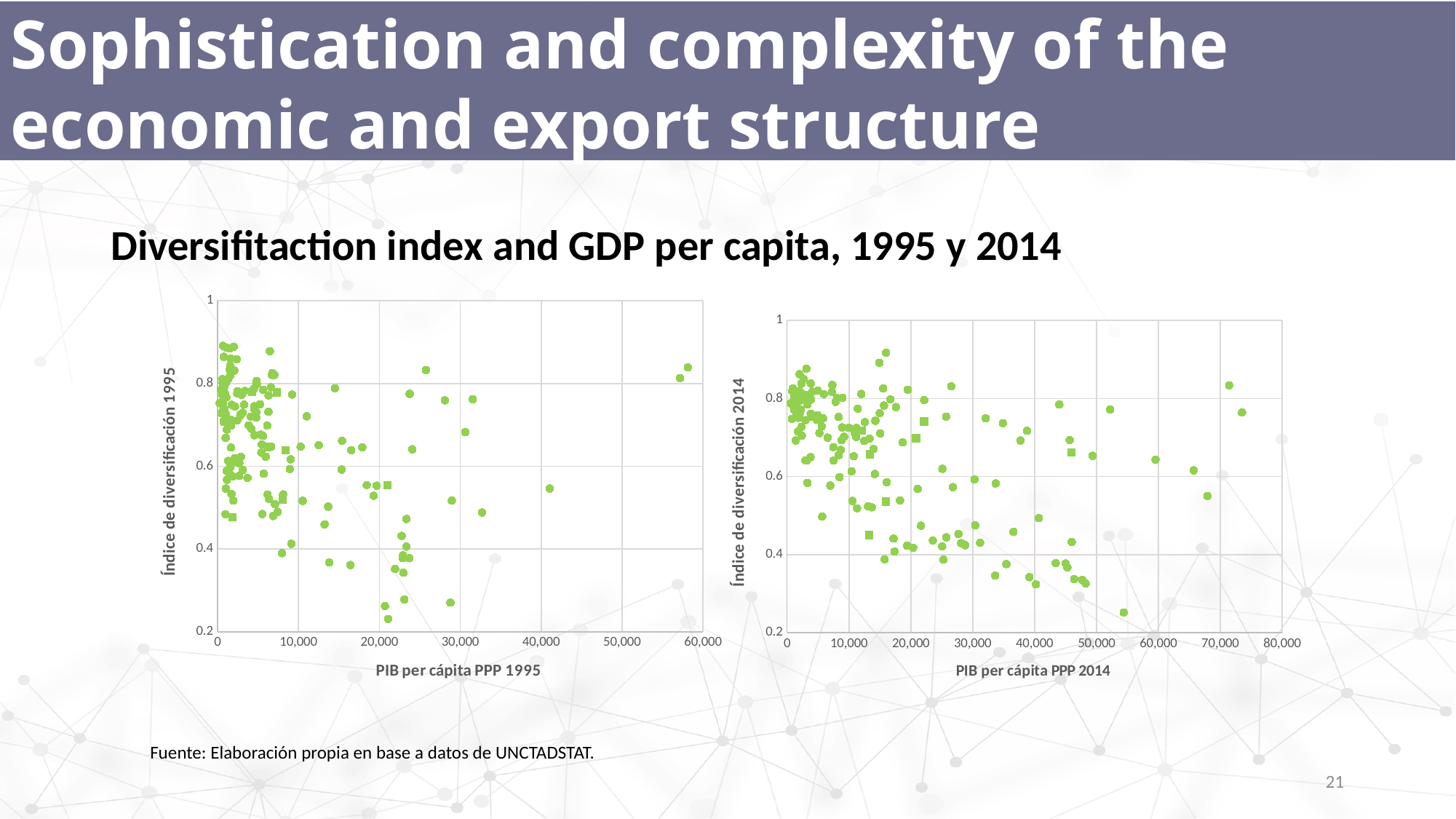
In the left chart (1995), do the diversification index values generally rise or fall as GDP per capita increases along the x axis? fall What is the x-axis title of the left chart? PIB per cápita PPP 1995 What kind of chart is the left chart (PIB per cápita PPP 1995)? scatter chart What kind of chart is the right chart (PIB per cápita PPP 2014)? scatter chart How many charts are shown on the slide? 2 In the right chart (2014), do the diversification index values generally rise or fall as GDP per capita increases along the x axis? fall What is the y-axis title of the right chart? Índice de diversificación 2014